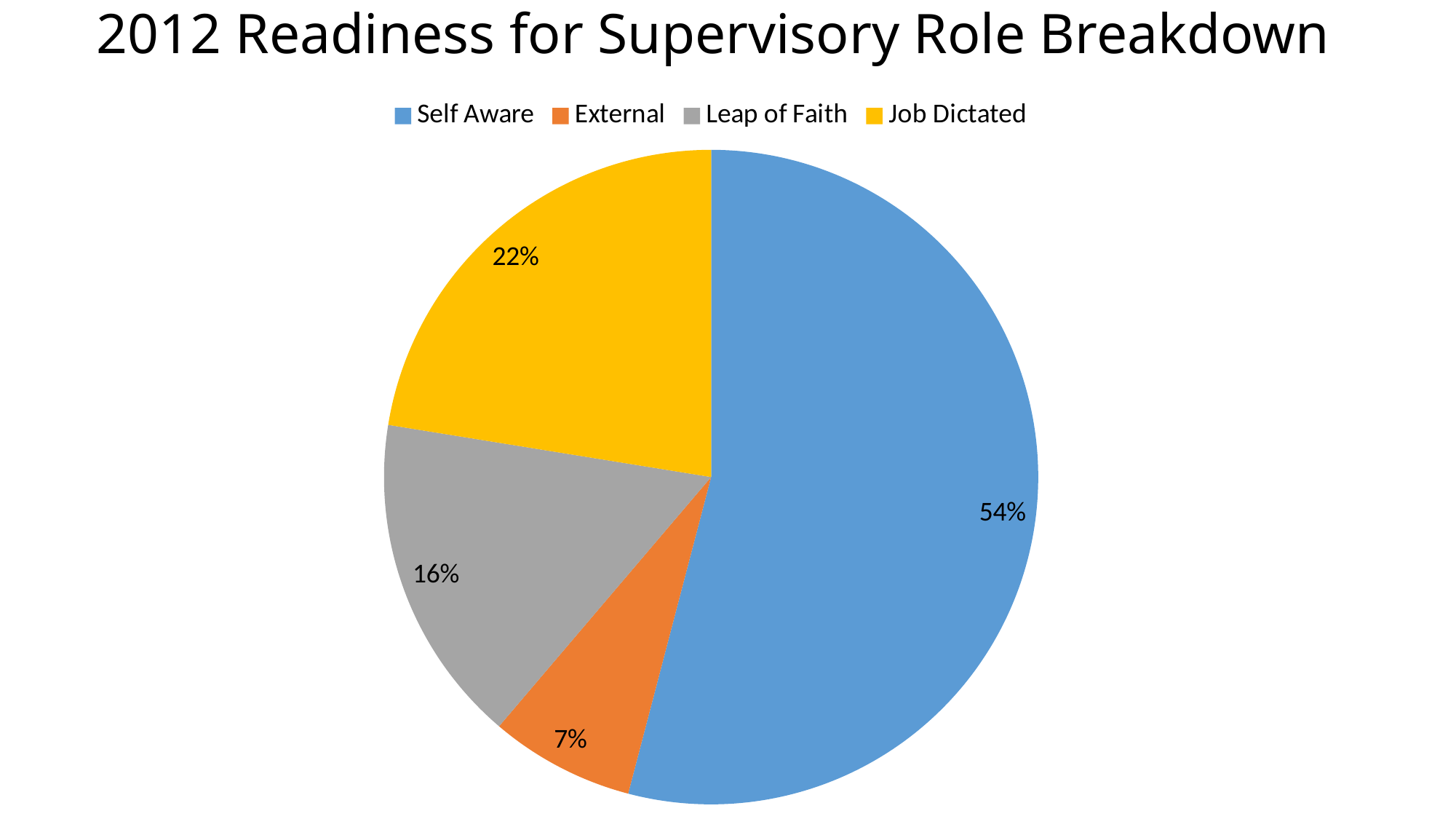
What is the value shown for External? 7% What is the difference between the Job Dictated and Leap of Faith shares? 6% What kind of chart is shown on the slide? Pie chart What share of the pie does Self Aware account for? 54% Which category has the smallest slice of the pie? External What is the difference between the Self Aware and External shares? 47% How many categories are shown in the pie chart? 4 What is the value shown for Leap of Faith? 16% Which category has the largest slice of the pie? Self Aware Which is larger, Leap of Faith or Job Dictated? Job Dictated What is the title of the chart? 2012 Readiness for Supervisory Role Breakdown What is the value shown for Job Dictated? 22%